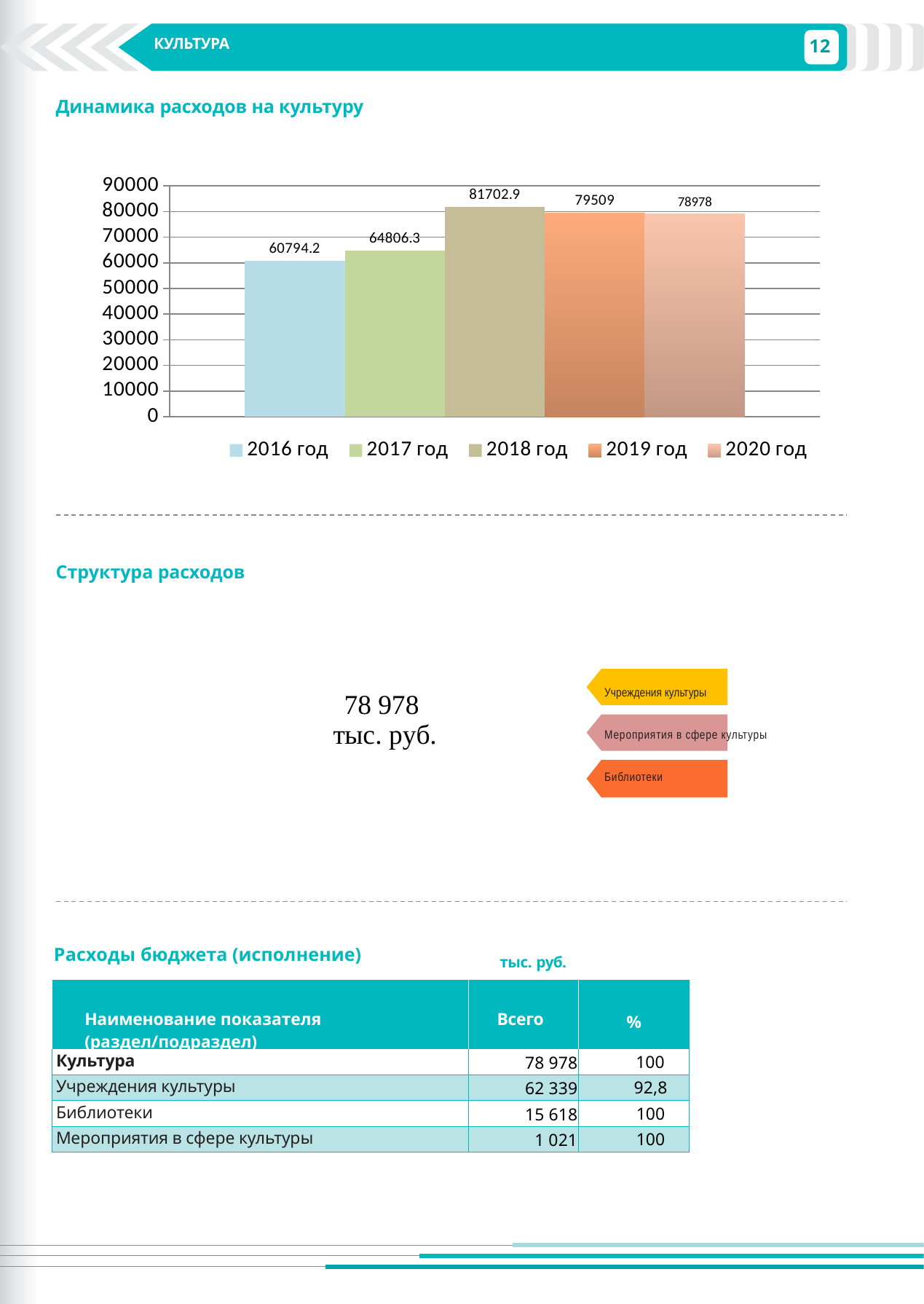
In the chart 'Динамика расходов на культуру', what is the difference between the values for 2019 год and 2020 год? 531 In the chart 'Динамика расходов на культуру', which is larger, the value for 2017 год or the value for 2019 год? 2019 год In the chart 'Динамика расходов на культуру', what is the value for 2020 год? 78978 How many bars are shown in the chart 'Динамика расходов на культуру'? 5 What kind of chart is 'Динамика расходов на культуру'? bar chart In the chart 'Динамика расходов на культуру', is the value for 2018 год greater or less than 80000? greater In the chart 'Динамика расходов на культуру', what is the value for 2018 год? 81702.9 How many entries does the legend of the chart 'Динамика расходов на культуру' list? 5 In the chart 'Динамика расходов на культуру', which year has the lowest value? 2016 год In the chart 'Динамика расходов на культуру', what is the value for 2016 год? 60794.2 In the chart 'Динамика расходов на культуру', what is the difference between the values for 2017 год and 2016 год? 4012.1 In the chart 'Динамика расходов на культуру', which year has the highest value? 2018 год